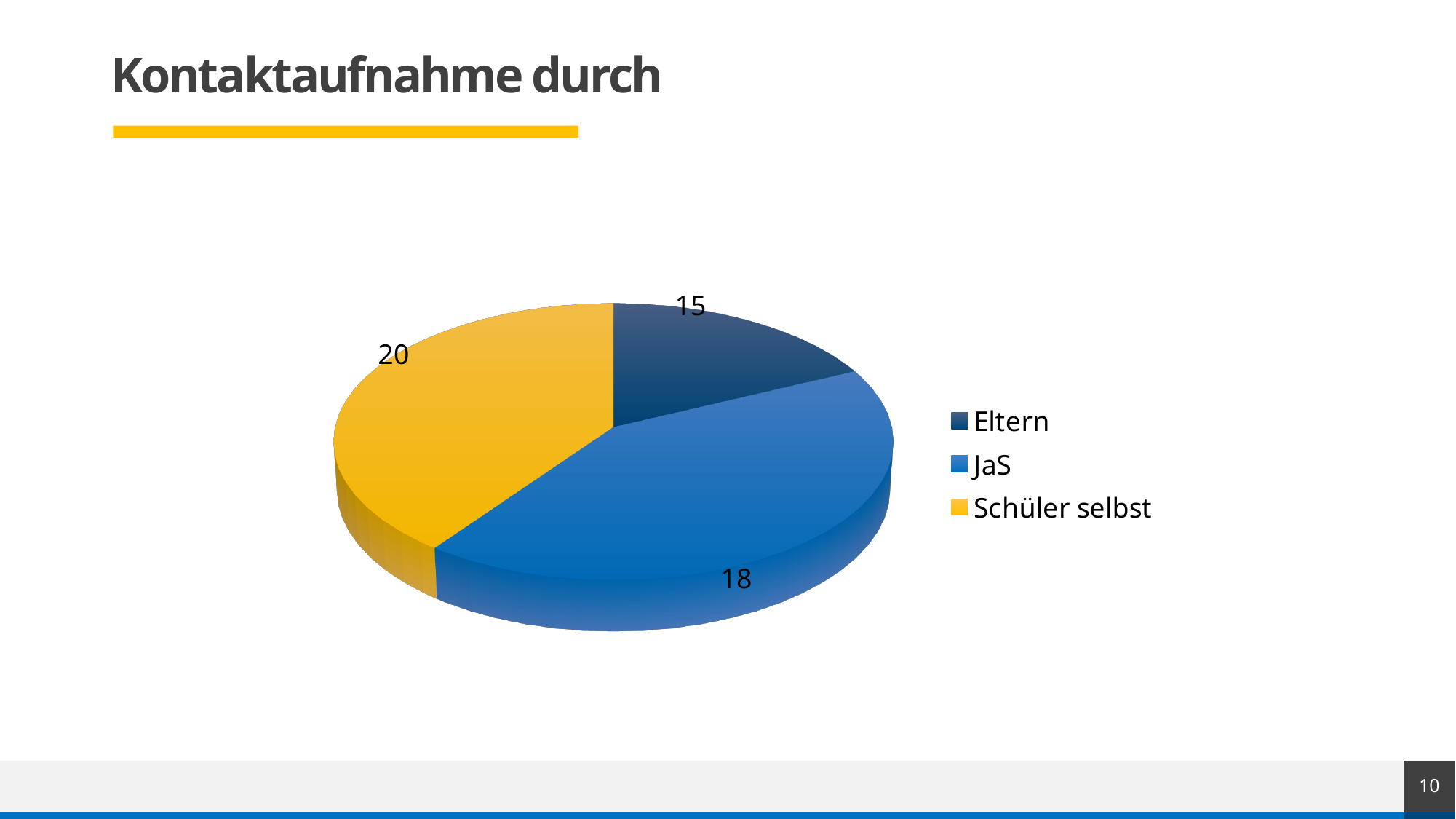
What is the value for Schüler selbst? 20 What is the title of the slide containing the chart? Kontaktaufnahme durch What is the difference between the values for JaS and Eltern? 3 What is the total of all slices in the pie chart? 53 What is the value for Eltern? 15 Which category has the smallest slice? Eltern Which is larger, the value for JaS or the value for Eltern? JaS How many slices does the pie chart have? 3 What is the value for JaS? 18 What is the difference between the values for Schüler selbst and Eltern? 5 What type of chart is shown on the slide? pie chart